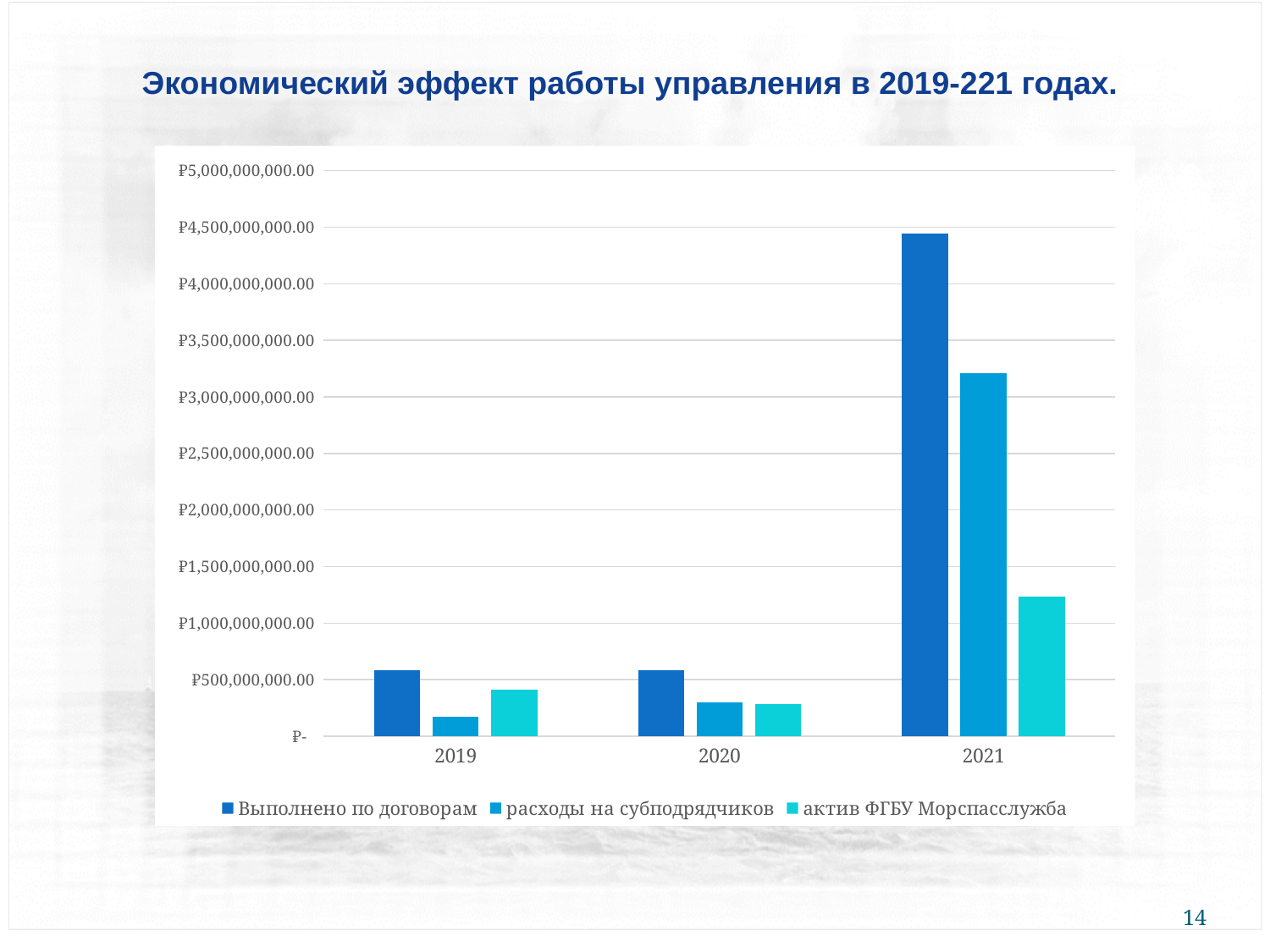
What is the title of the slide? Экономический эффект работы управления в 2019-221 годах. Is the value for расходы на субподрядчиков in 2019 greater or less than ₽500,000,000.00? less In 2021, which is larger: Выполнено по договорам or расходы на субподрядчиков? Выполнено по договорам In 2019, which is larger: актив ФГБУ Морспасслужба or расходы на субподрядчиков? актив ФГБУ Морспасслужба Is the value for расходы на субподрядчиков in 2021 greater or less than ₽3,000,000,000.00? greater Is the value for Выполнено по договорам in 2021 greater or less than ₽4,000,000,000.00? greater How many series does the legend list? 3 In which year is the value for Выполнено по договорам highest? 2021 In which year is the value for расходы на субподрядчиков lowest? 2019 How many years (categories) are shown on the x axis? 3 What kind of chart is shown on the slide? bar chart